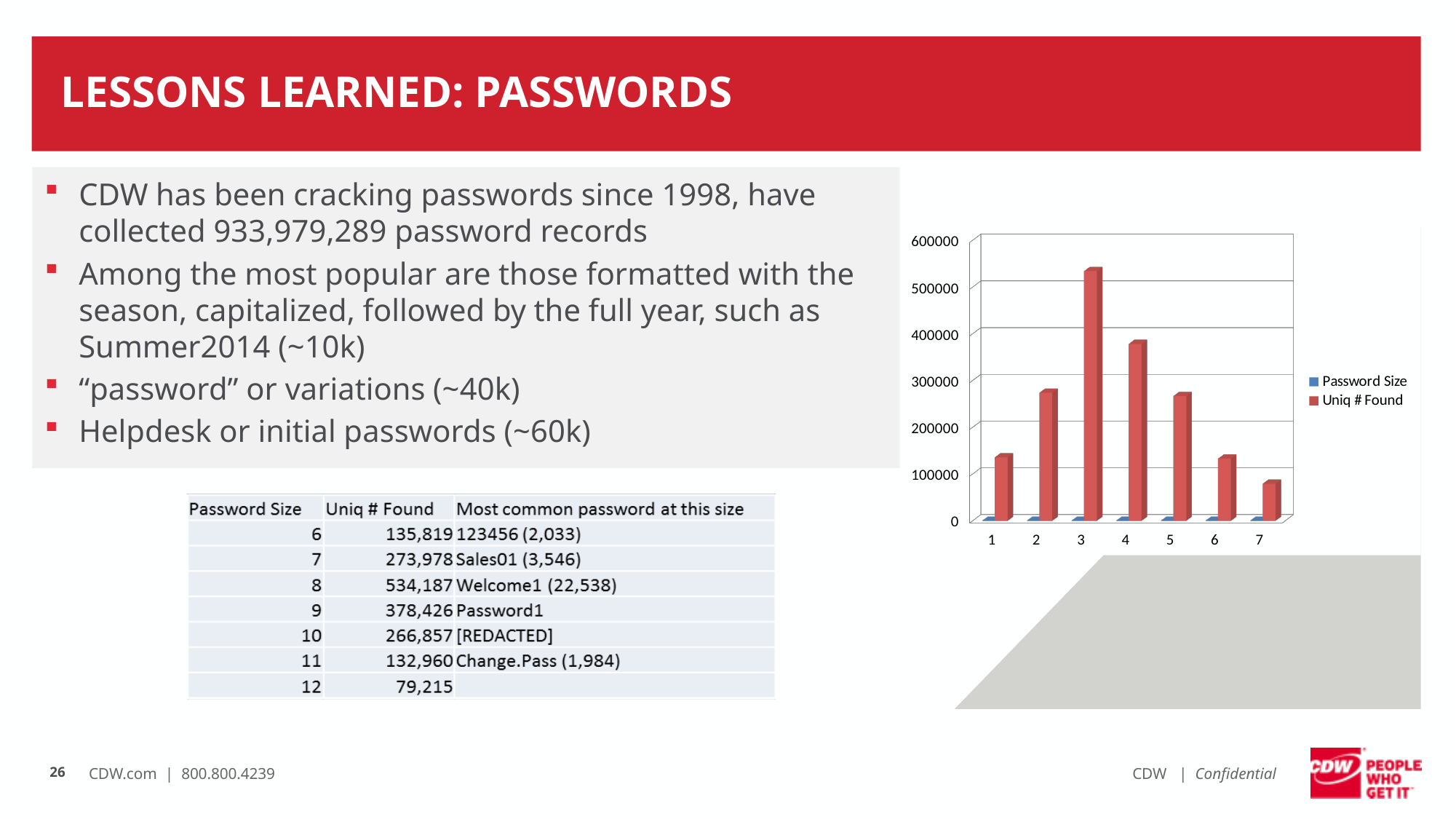
What kind of chart is shown on the right of the slide? bar chart Is the Uniq # Found value for category 2 greater or less than 200000? greater What are the two series names listed in the chart's legend? Password Size and Uniq # Found Which has a larger Uniq # Found bar, category 4 or category 5? 4 Is the Uniq # Found value for category 3 greater or less than 500000? greater How many series does the chart's legend list? 2 Do the Uniq # Found bars rise or fall from category 3 to category 7? fall Is the Uniq # Found value for category 7 greater or less than 100000? less Which category has the highest Uniq # Found bar in the chart? 3 How many categories are shown on the x axis of the chart? 7 Which category has the lowest Uniq # Found bar in the chart? 7